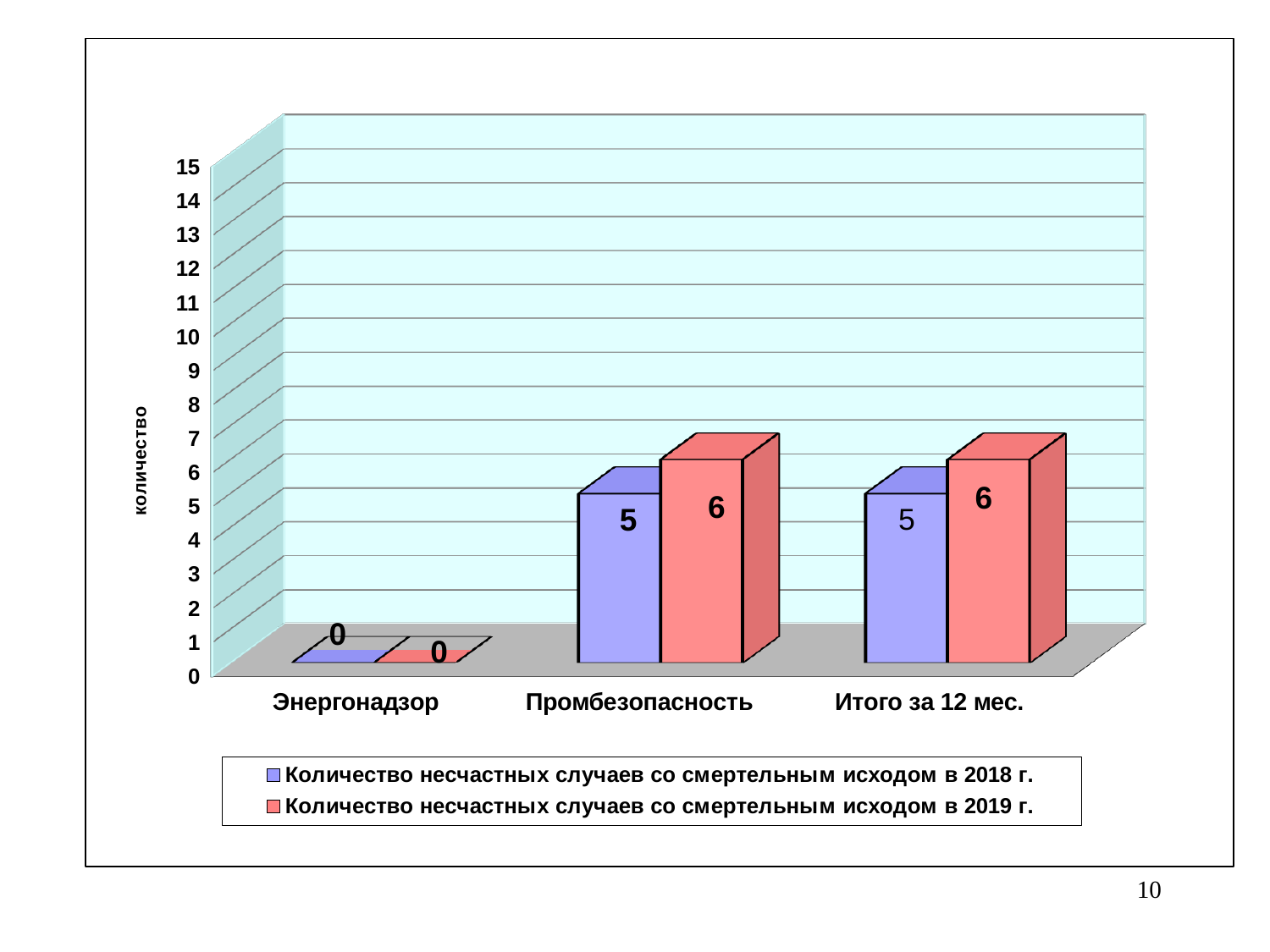
What is the value for Энергонадзор in the 2018 series? 0 What is the difference between the 2019 and 2018 values for Промбезопасность? 1 For 'Итого за 12 мес.', which series has the larger value, 2018 or 2019? 2019 What is the value for 'Итого за 12 мес.' in the 2019 series? 6 What is the label of the vertical axis? количество What is the value for Промбезопасность in the series 'Количество несчастных случаев со смертельным исходом в 2018 г.'? 5 How many categories are shown on the x axis? 3 How many series does the legend list? 2 What kind of chart is shown on the slide? bar chart Is the 2019 value for Промбезопасность greater or less than 10? less What is the value for Промбезопасность in the series 'Количество несчастных случаев со смертельным исходом в 2019 г.'? 6 Which category has the lowest value in the 2019 series? Энергонадзор